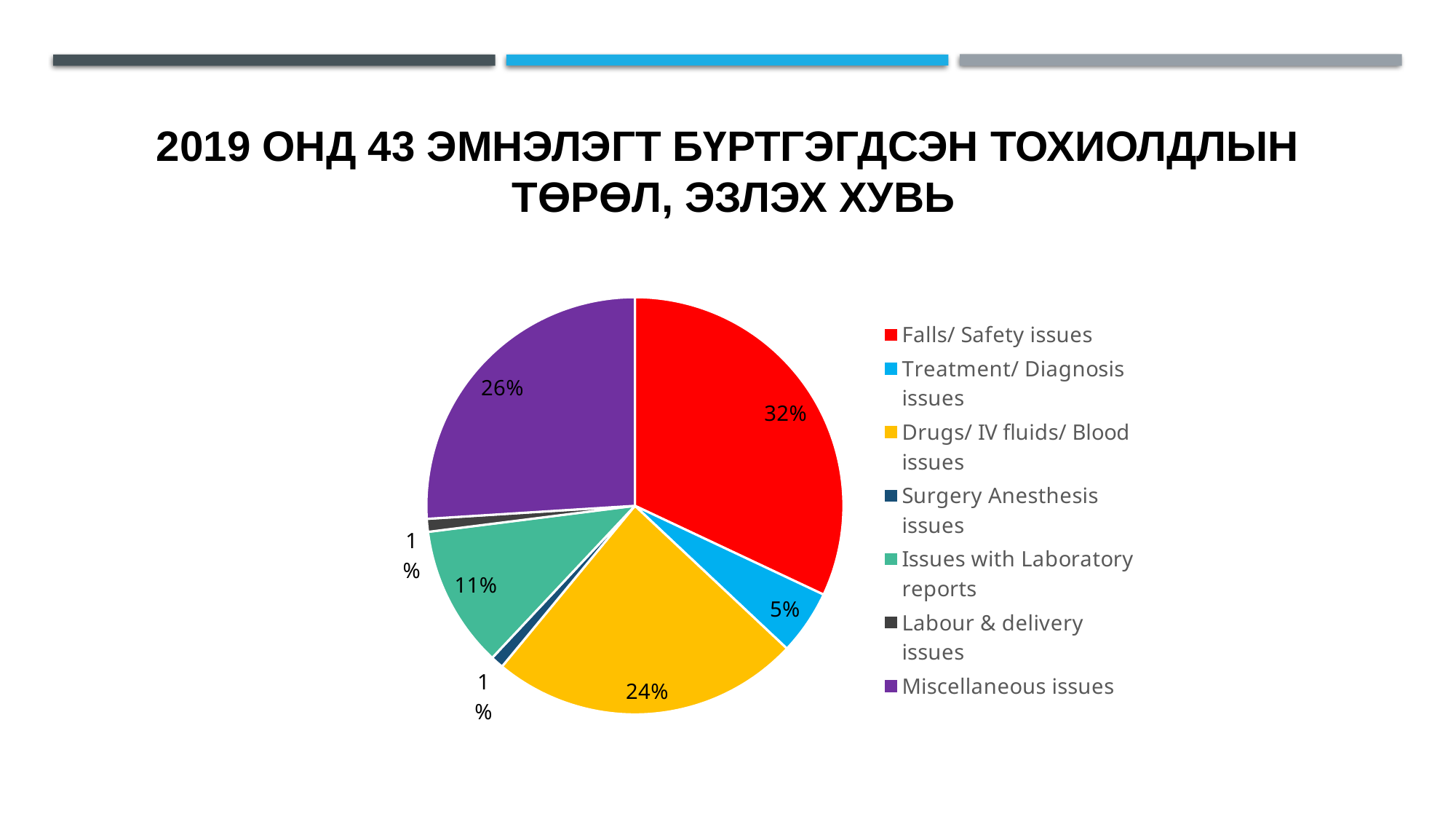
What colour is the slice for Miscellaneous issues? Purple Which is larger, the share for Drugs/ IV fluids/ Blood issues or the share for Issues with Laboratory reports? Drugs/ IV fluids/ Blood issues What share of the pie is Drugs/ IV fluids/ Blood issues? 24% What is the difference in percentage points between Falls/ Safety issues and Miscellaneous issues? 6 What share of the pie is Miscellaneous issues? 26% What kind of chart is shown on the slide? Pie chart What share of the pie is Issues with Laboratory reports? 11% Which category has the largest share of the pie? Falls/ Safety issues How many categories does the legend list? 7 What is the combined share of Falls/ Safety issues and Treatment/ Diagnosis issues? 37%